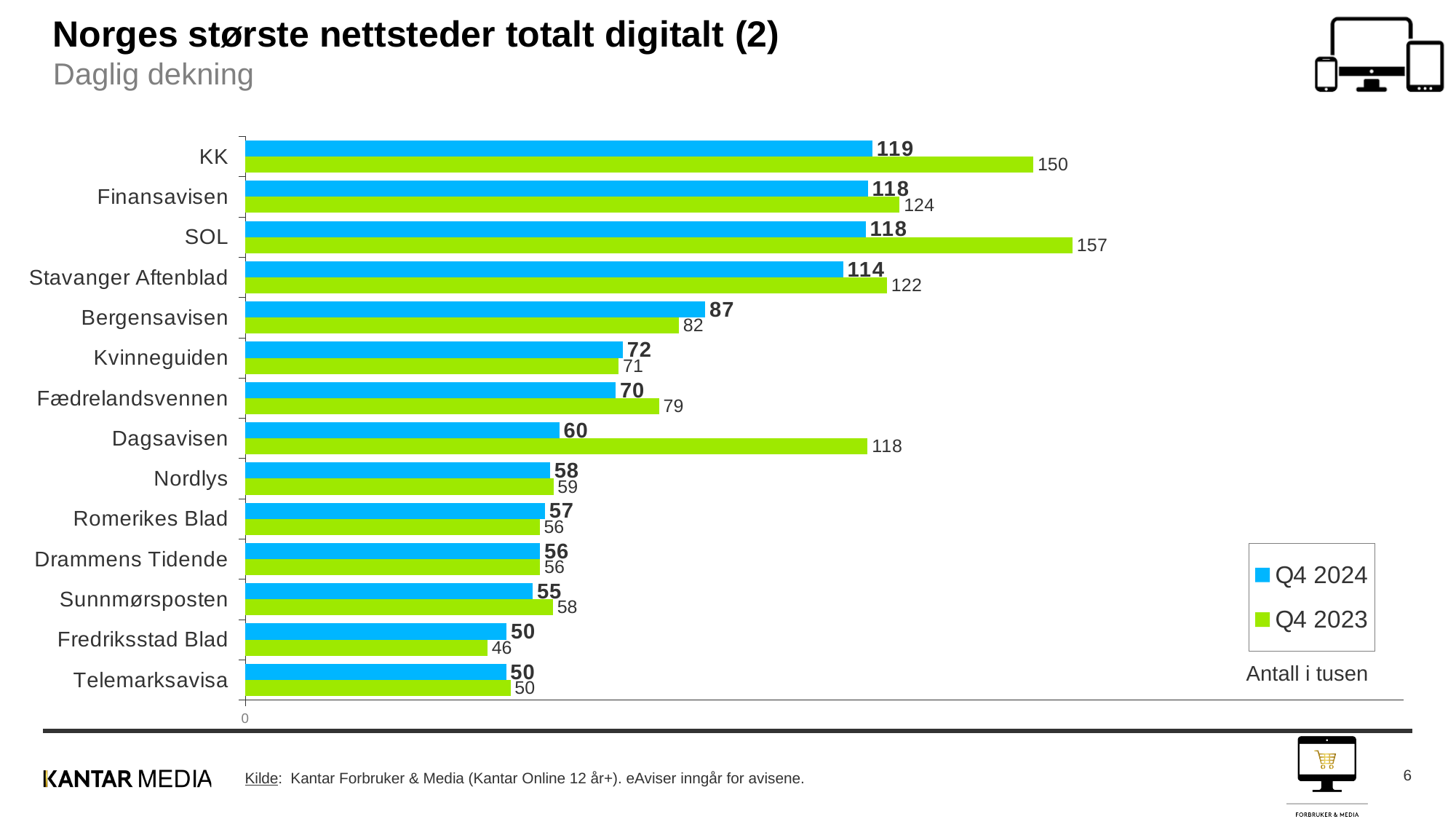
Which is larger for Bergensavisen: the Q4 2024 value or the Q4 2023 value? Q4 2024 What unit does the chart note say the values are in? Antall i tusen What kind of chart is shown on the slide? Bar chart What is the Q4 2023 value for Dagsavisen? 118 How many categories (websites) are shown in the chart? 14 Which category has the highest Q4 2023 value? SOL Which category has the lowest Q4 2023 value? Fredriksstad Blad How many series does the legend list? 2 What is the Q4 2023 value for SOL? 157 What is the difference between the Q4 2023 and Q4 2024 values for KK? 31 What is the difference between the Q4 2023 and Q4 2024 values for Dagsavisen? 58 What is the Q4 2024 value for KK? 119